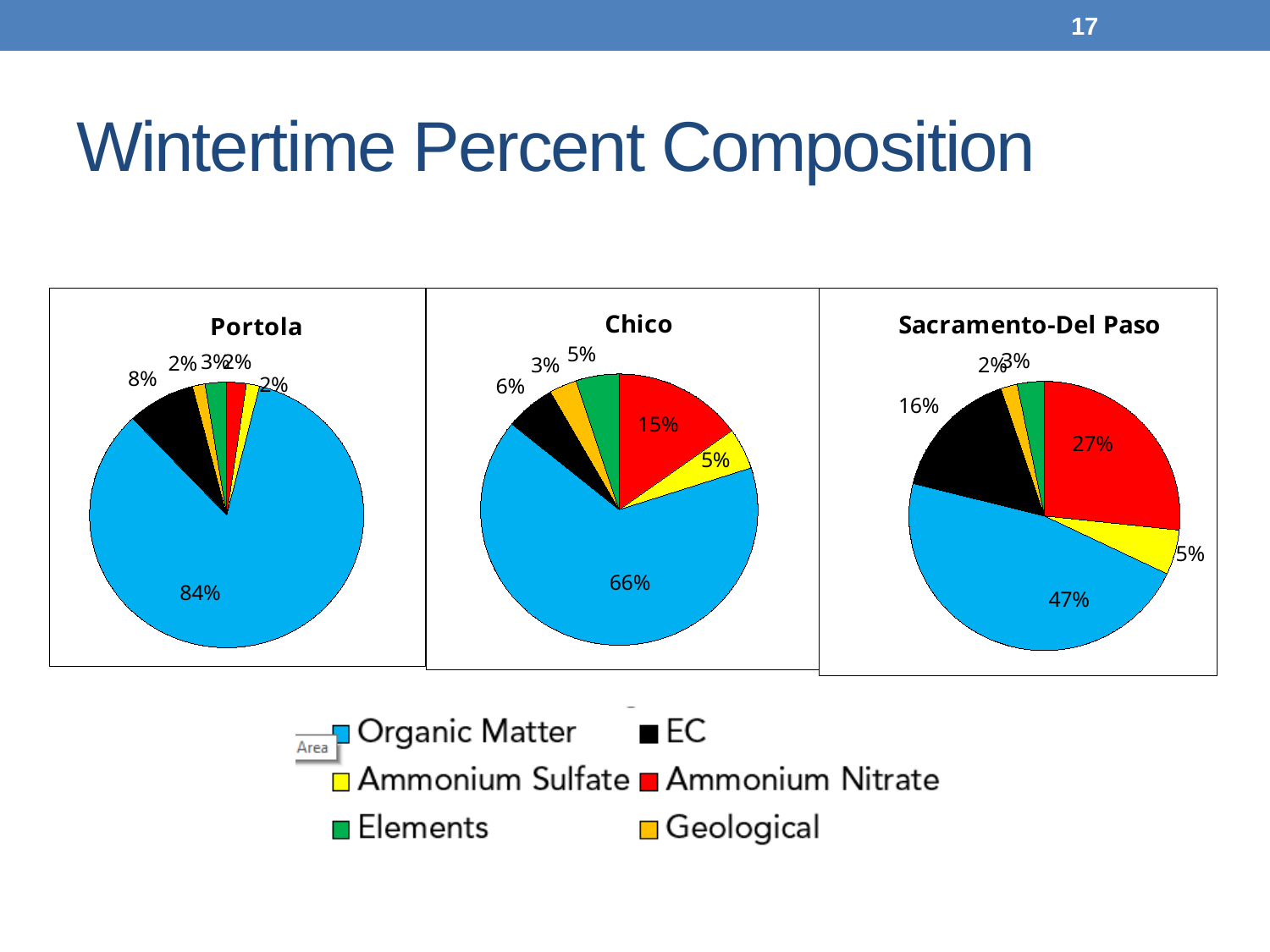
In the Sacramento-Del Paso chart, what percentage is Ammonium Nitrate? 27% In the Chico chart, what percentage is Organic Matter? 66% In the Chico chart, which component has the smallest share? Geological In the Sacramento-Del Paso chart, what percentage is EC? 16% In the Portola chart, what percentage is EC? 8% In the Chico chart, what is the difference between the Organic Matter share and the Ammonium Nitrate share? 51% In the Chico chart, what percentage is Ammonium Nitrate? 15% In the Sacramento-Del Paso chart, which component has the largest share? Organic Matter In the Portola chart, what percentage is Organic Matter? 84% What type of chart is used for Portola, Chico and Sacramento-Del Paso? Pie chart Which chart has the larger Ammonium Nitrate share, Chico or Sacramento-Del Paso? Sacramento-Del Paso How many components does the legend list? 6